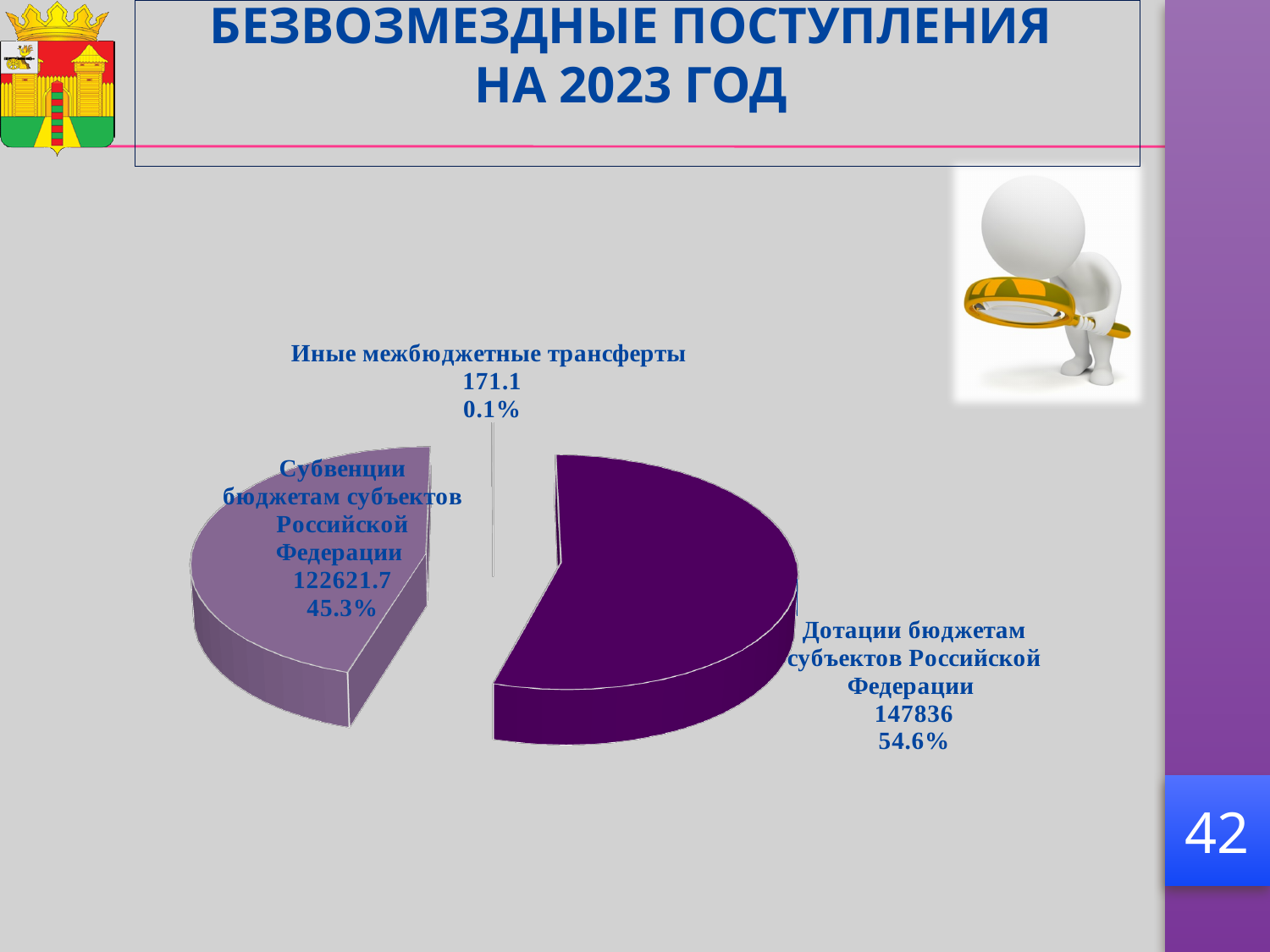
How many slices does the pie chart have? 3 Which category has the largest slice of the pie? Дотации бюджетам субъектов Российской Федерации Which category has the smallest slice of the pie? Иные межбюджетные трансферты What is the title of the slide containing the pie chart? БЕЗВОЗМЕЗДНЫЕ ПОСТУПЛЕНИЯ НА 2023 ГОД What is the value shown for Иные межбюджетные трансферты? 171.1 What share of the pie does Субвенции бюджетам субъектов Российской Федерации represent? 45.3% What share of the pie does Иные межбюджетные трансферты represent? 0.1% What is the difference between the values for Дотации бюджетам субъектов Российской Федерации and Субвенции бюджетам субъектов Российской Федерации? 25214.3 What share of the pie does Дотации бюджетам субъектов Российской Федерации represent? 54.6% What type of chart is shown on the slide? pie chart What is the value shown for Субвенции бюджетам субъектов Российской Федерации? 122621.7 What is the value shown for Дотации бюджетам субъектов Российской Федерации? 147836